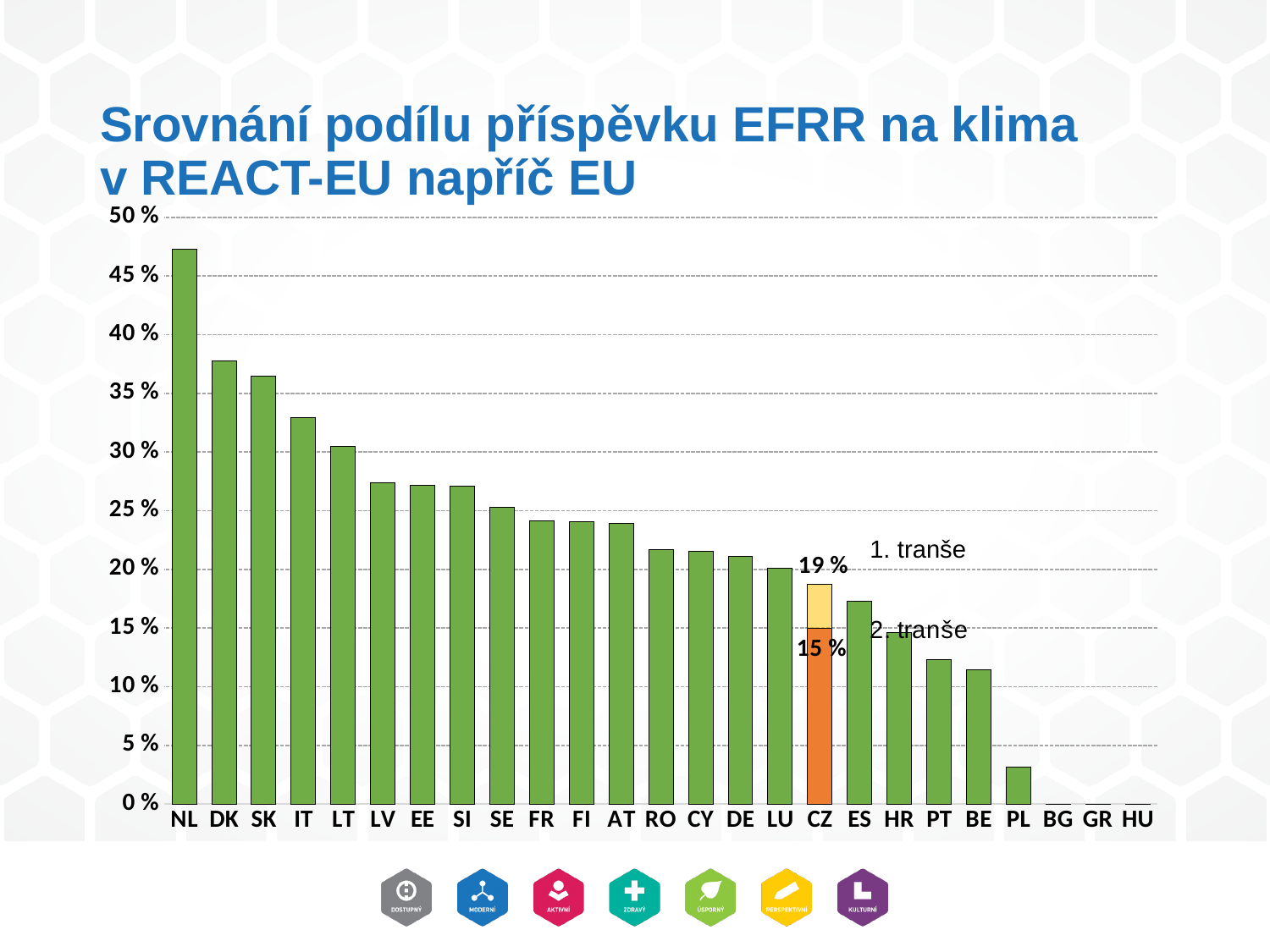
Is the value for NL greater or less than 45 %? greater What is the difference between the two values printed on the CZ bar? 4 % What value is printed at the top of the CZ bar? 19 % How many countries are shown on the x axis of the chart? 25 What kind of chart is shown on the slide? bar chart Which has the larger value, NL or DK? NL Which country has the highest bar in the chart? NL Do the bar values generally rise or fall from left to right along the x axis? fall Is the value for ES greater or less than 20 %? less Is the value for PL greater or less than 5 %? less Which country's bar is highlighted in a different colour from the green bars? CZ What is the lower value printed on the CZ bar? 15 %